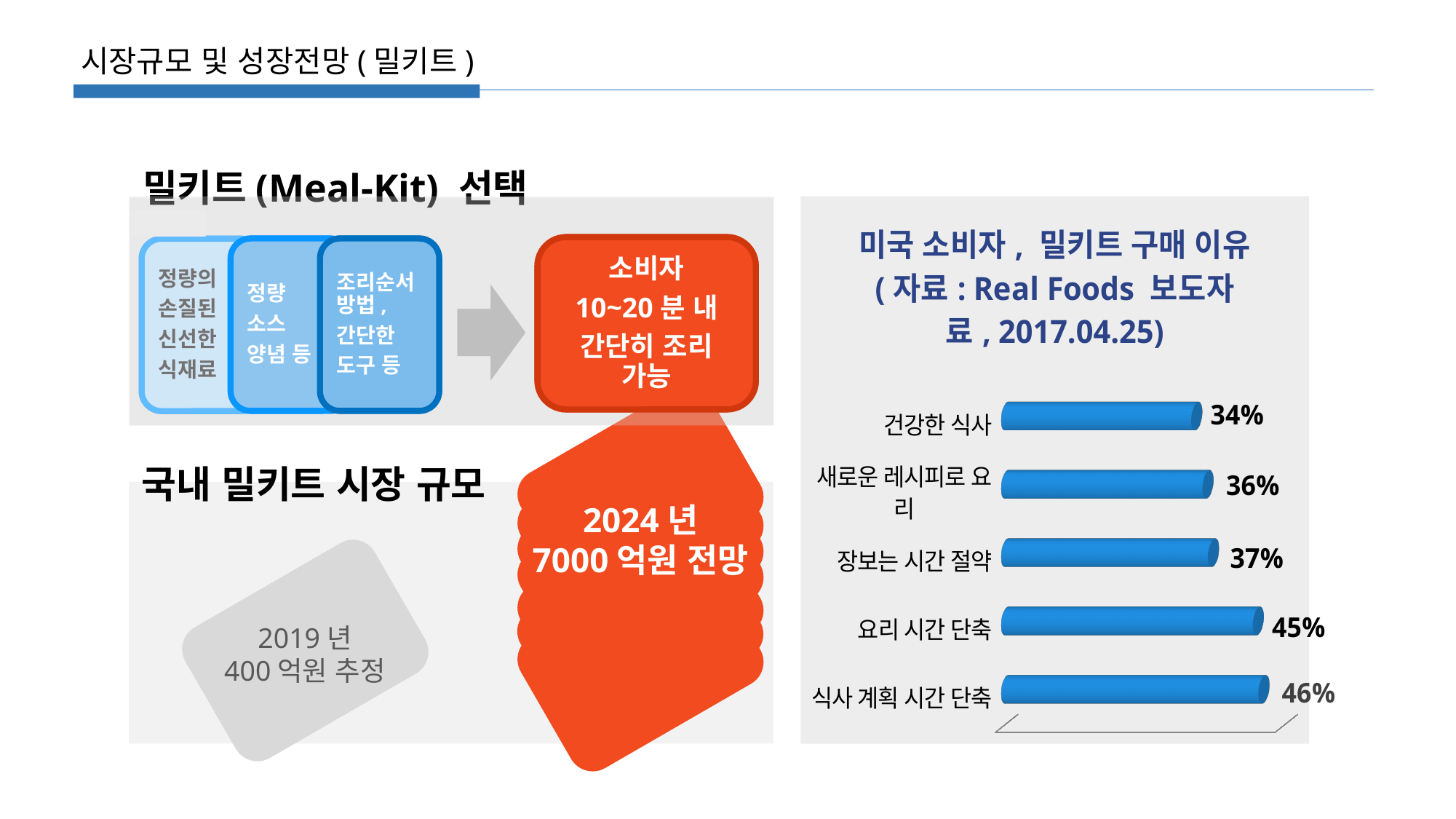
In the chart on the right, what is the value for 식사 계획 시간 단축? 46% In the chart on the right, which category has the highest value? 식사 계획 시간 단축 How many categories are shown in the chart on the right? 5 What is the source cited in the title of the chart on the right? Real Foods 보도자료, 2017.04.25 In the chart on the right, which is larger: the value for 요리 시간 단축 or the value for 장보는 시간 절약? 요리 시간 단축 In the chart on the right, what is the difference between the values for 식사 계획 시간 단축 and 건강한 식사? 12% In the chart on the right, what is the value for 장보는 시간 절약? 37% In the chart on the right, what is the value for 요리 시간 단축? 45% What type of chart is shown on the right side of the slide? bar chart In the chart on the right, what is the value for 건강한 식사? 34% In the chart on the right, what is the value for 새로운 레시피로 요리? 36% In the chart on the right, which category has the lowest value? 건강한 식사